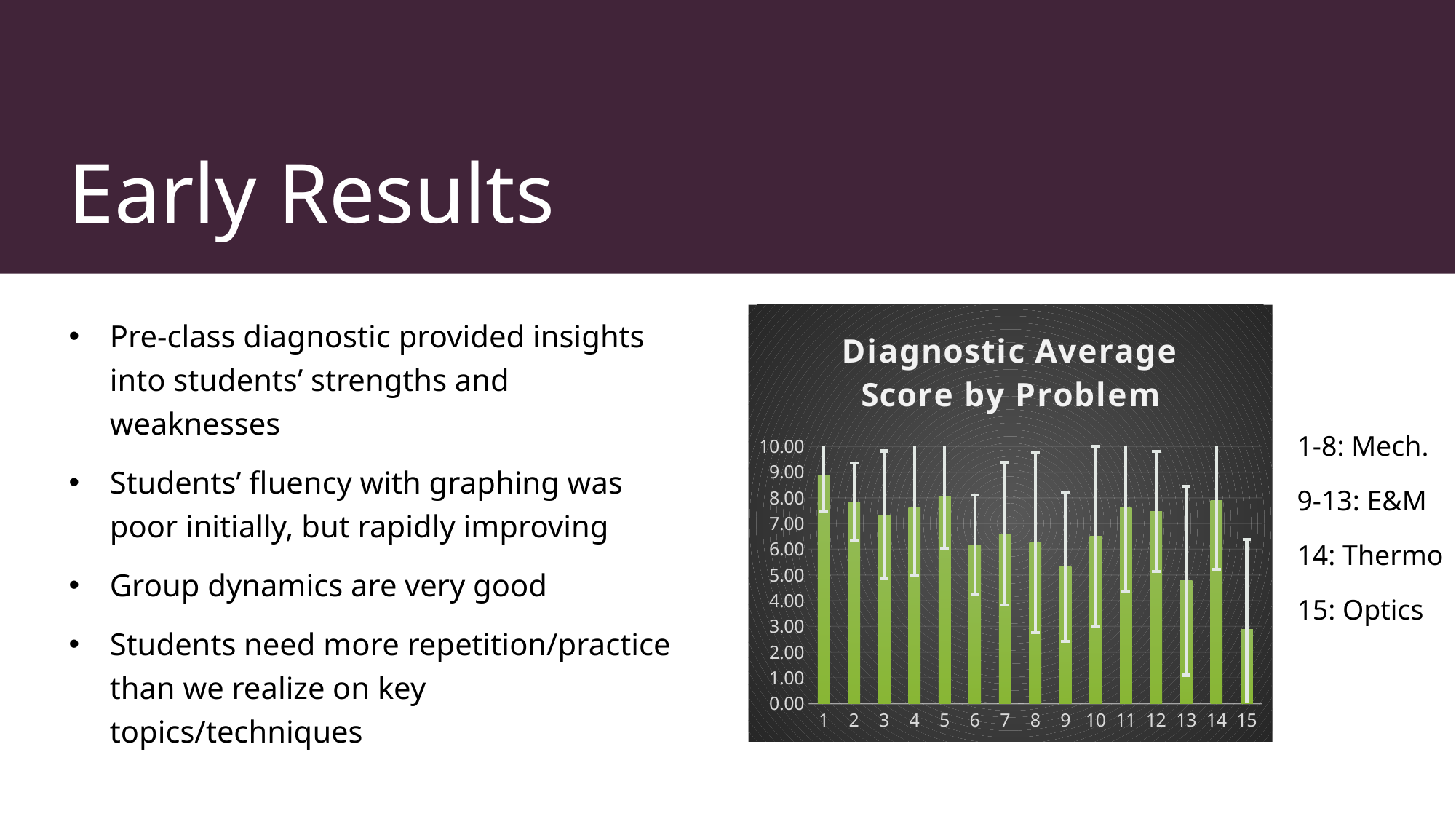
What is the title of the chart? Diagnostic Average Score by Problem Which has the higher average score, problem 2 or problem 9? problem 2 Which has the lower average score, problem 13 or problem 5? problem 13 How many problems are plotted on the x axis of the chart? 15 Is the average score for problem 13 greater or less than 6.00? less What is the highest value shown on the chart's y axis? 10.00 Which problem has the highest average score in the chart? 1 Which problem has the lowest average score in the chart? 15 Is the average score for problem 1 greater or less than 8.00? greater What kind of chart is shown on the slide? bar chart Is the average score for problem 15 greater or less than 4.00? less